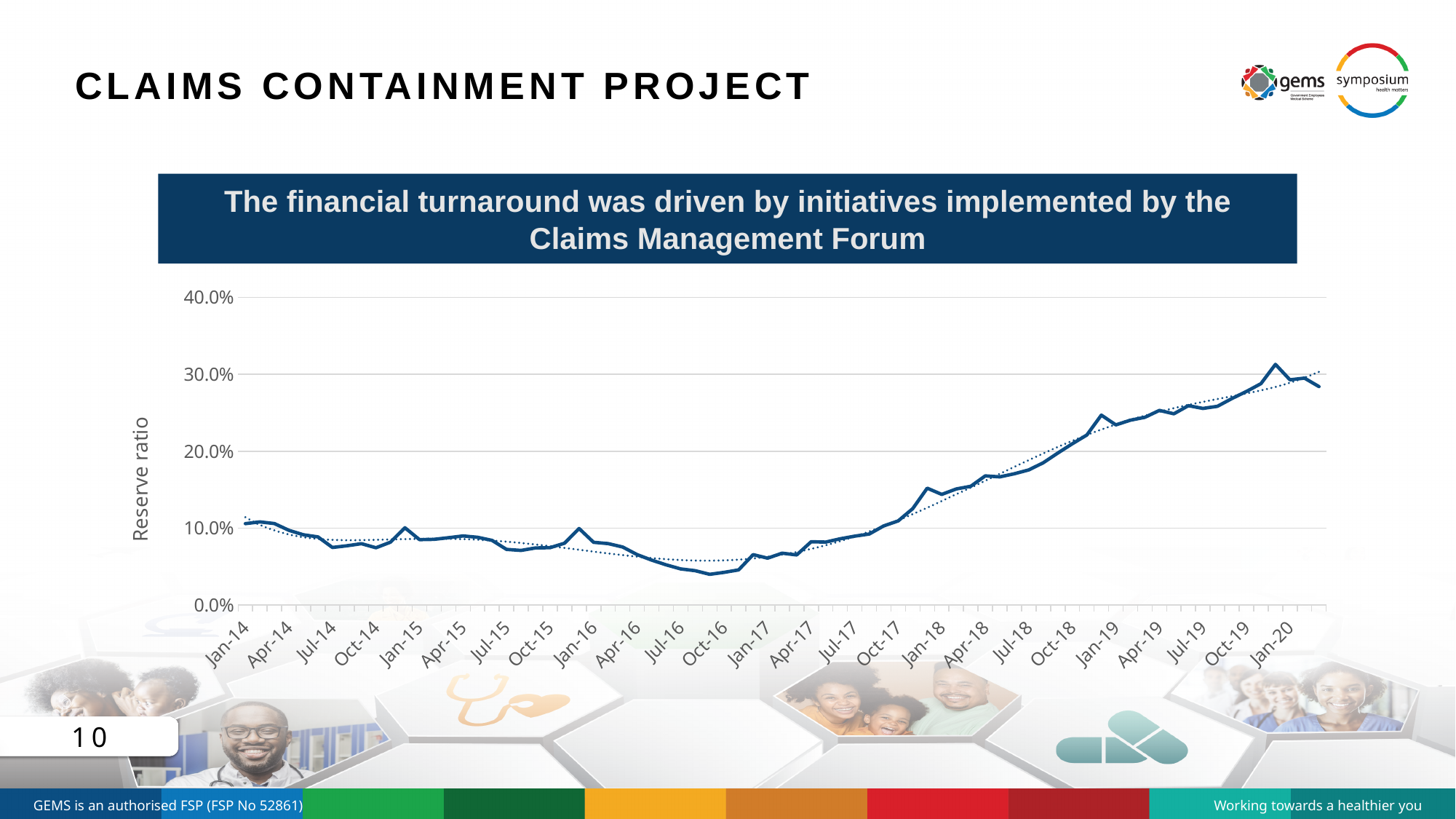
Overall, does the reserve ratio rise or fall from Jan-14 to Jan-20? rise Is the reserve ratio for Jan-14 greater or less than 20.0%? less Is the reserve ratio for Oct-16 greater or less than 10.0%? less What is the highest value shown on the vertical axis? 40.0% What kind of chart is shown on the slide? line chart What is the label on the vertical axis of the chart? Reserve ratio Which has the larger reserve ratio, Oct-16 or Jan-18? Jan-18 In which year does the reserve ratio reach its lowest point? 2016 How many date labels are shown along the x axis? 25 Is the reserve ratio for Apr-18 greater or less than 20.0%? less Which has the larger reserve ratio, Jan-14 or Jan-20? Jan-20